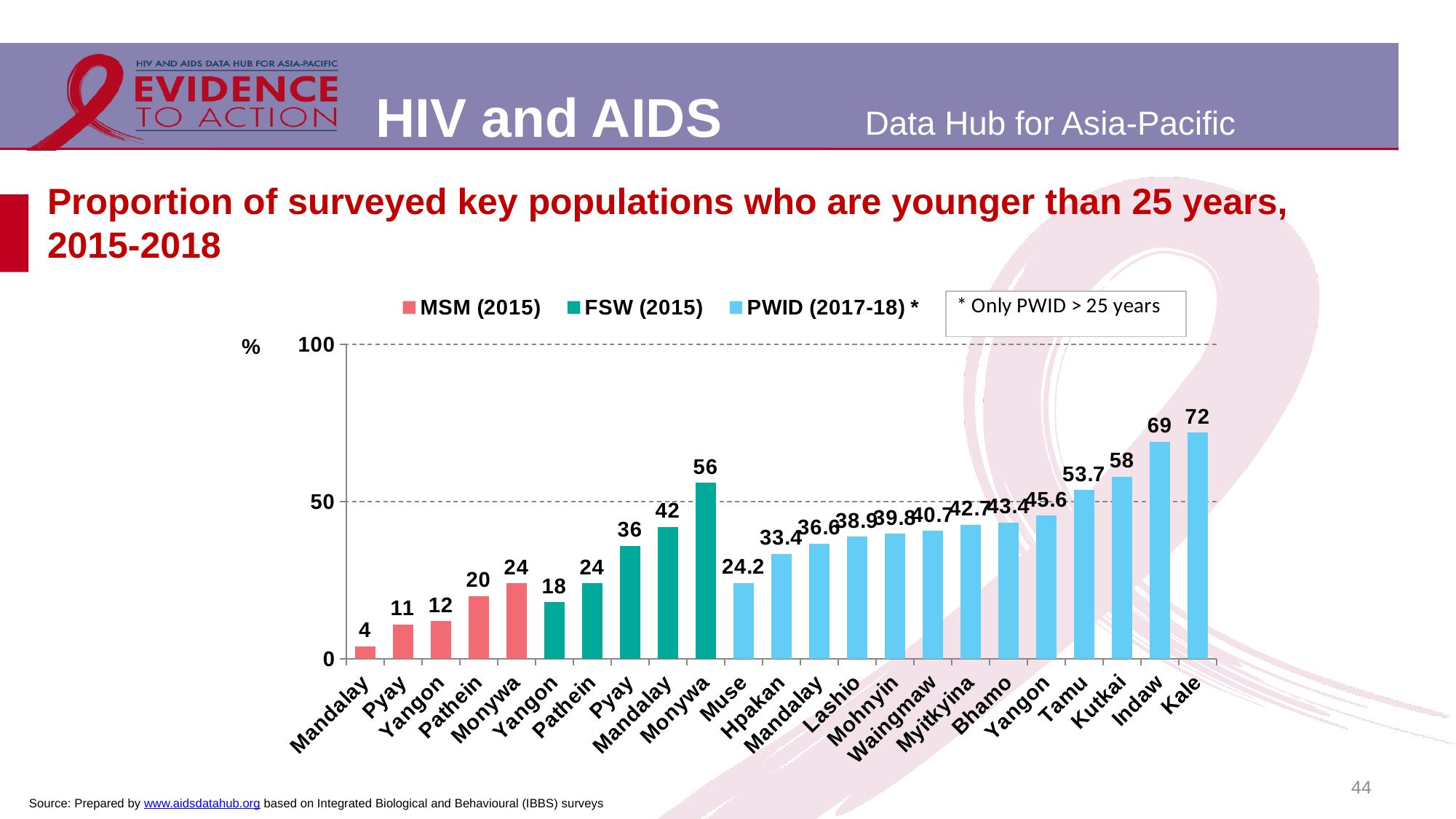
What is the difference between the FSW (2015) value for Monywa and the MSM (2015) value for Monywa? 32 Is the value for Tamu in the PWID (2017-18) series greater or less than 50? greater What is the value for Mandalay in the MSM (2015) series? 4 What is the value for Monywa in the FSW (2015) series? 56 What is the value for Muse in the PWID (2017-18) series? 24.2 What kind of chart is shown on the slide? Bar chart Which is larger: the FSW (2015) value for Pyay or the MSM (2015) value for Pyay? FSW (2015) Which location has the highest value in the chart? Kale Do the PWID (2017-18) values rise or fall from Muse to Kale along the x axis? Rise Which location has the lowest value in the chart? Mandalay (MSM) How many series does the legend list? 3 What is the difference between the values for Kale and Indaw in the PWID (2017-18) series? 3